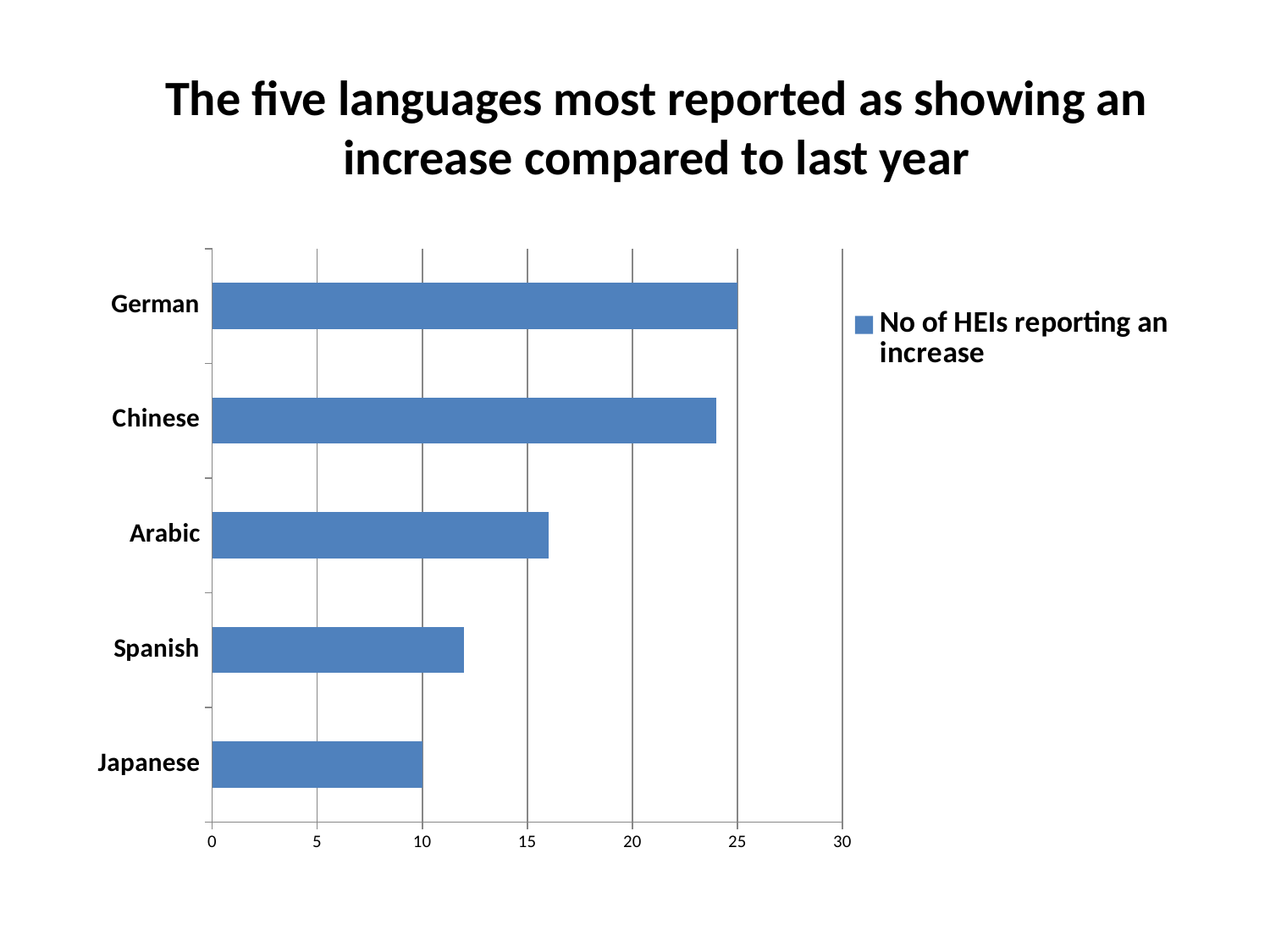
Is the value for Arabic greater or less than 15? greater What is the legend entry for the series in the chart? No of HEIs reporting an increase Is the value for Spanish greater or less than 15? less What is the number of HEIs reporting an increase for German? 25 How many series does the legend list? 1 What kind of chart is shown on the slide? bar chart Is the value for Chinese greater or less than 20? greater Which language has the highest number of HEIs reporting an increase? German Which language has the lowest number of HEIs reporting an increase? Japanese What is the number of HEIs reporting an increase for Japanese? 10 Which has more HEIs reporting an increase, Arabic or Spanish? Arabic How many languages are shown in the chart? 5